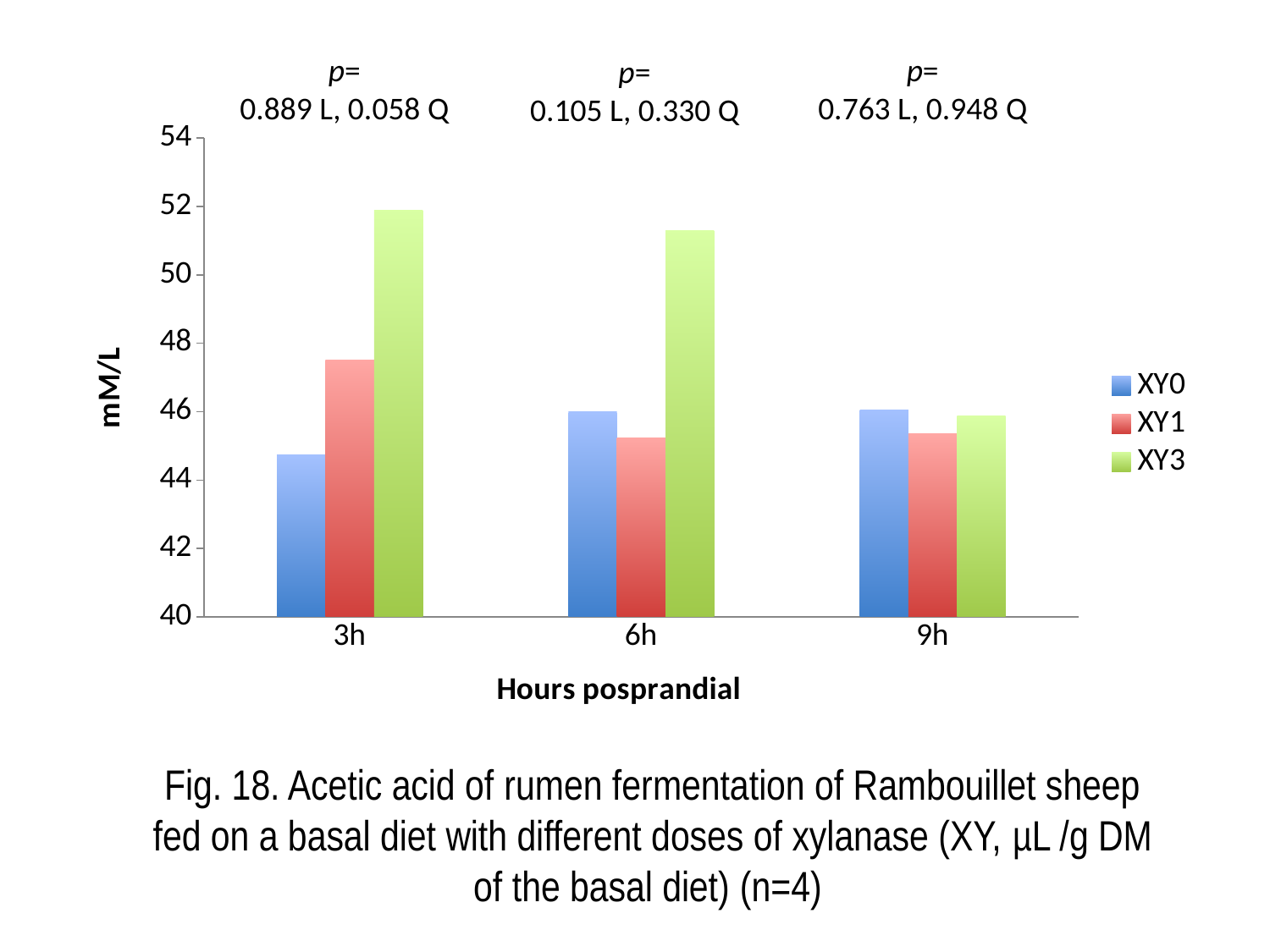
What p-values are shown above the 3h group? p= 0.889 L, 0.058 Q Is the value for XY3 at 6h greater or less than 50 mM/L? greater Is the value for XY1 at 6h greater or less than 46 mM/L? less Which treatment has the lowest acetic acid value at 6h? XY1 What is the label of the y axis? mM/L Is the value for XY0 at 3h greater or less than 46 mM/L? less Which treatment has the highest acetic acid value at 3h? XY3 How many time-point categories are shown on the x axis? 3 What kind of chart is shown on the slide? bar chart At 3h, which is larger, the value for XY0 or the value for XY1? XY1 How many series does the legend list? 3